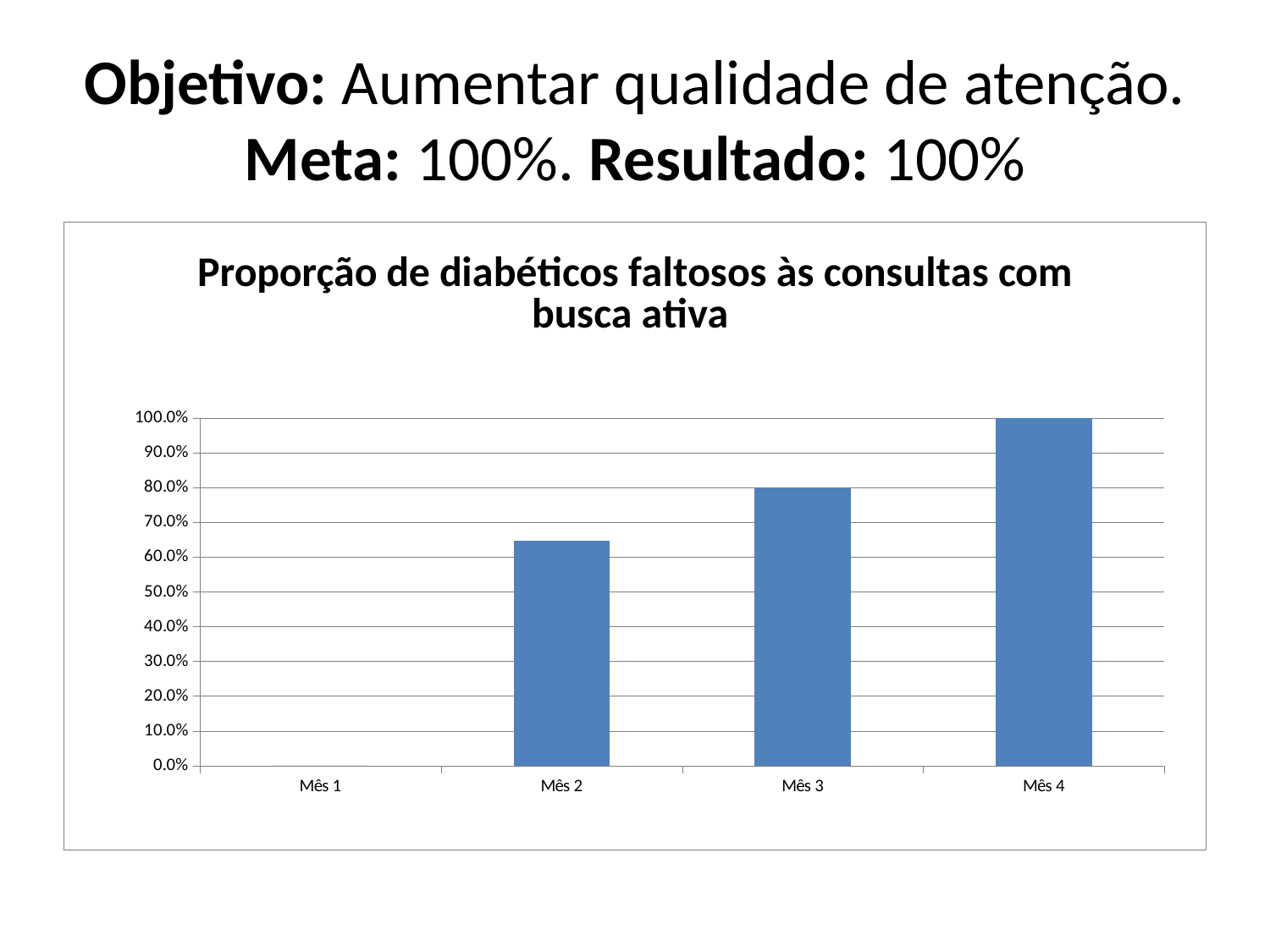
What is the value for Mês 1? 0.0% How many categories (months) are plotted on the chart? 4 What is the value for Mês 4? 100.0% Is the value for Mês 2 greater or less than 70.0%? less Which is larger, the value for Mês 2 or the value for Mês 3? Mês 3 Which month has the lowest value on the chart? Mês 1 Is the value for Mês 2 greater or less than 60.0%? greater What kind of chart is shown on the slide? bar chart Do the values rise or fall from Mês 1 to Mês 4? rise Which month has the highest value on the chart? Mês 4 What is the title of the chart? Proporção de diabéticos faltosos às consultas com busca ativa